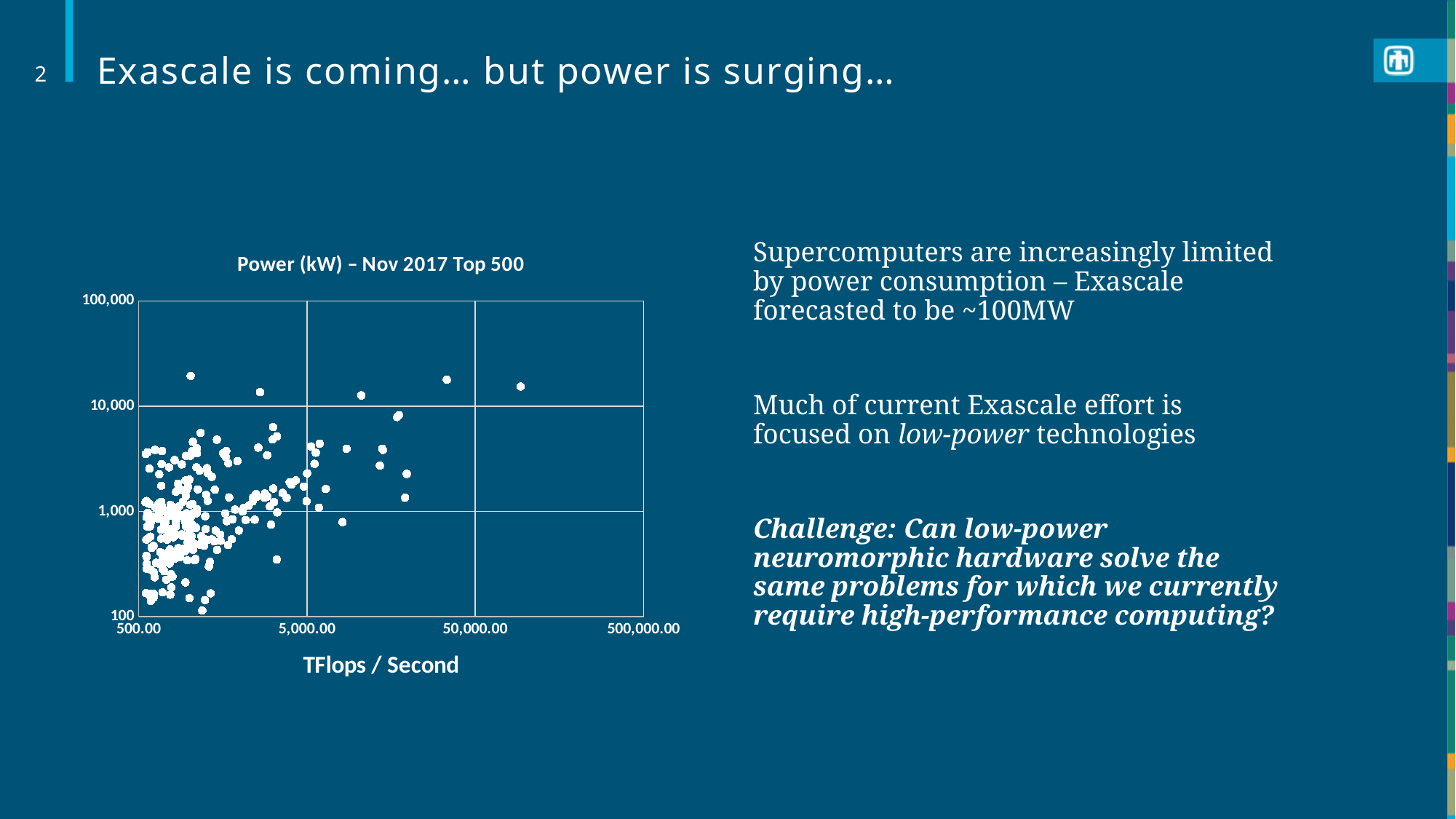
In general, does power tend to rise or fall as TFlops / Second increases along the x axis? Rise How many y-axis tick labels are shown on the chart? 4 What is the smallest tick value shown on the x axis of the chart? 500.00 Is the power value of the rightmost point in the chart greater or less than 10,000? greater What kind of chart is shown on the slide? Scatter chart Are the points in the chart mostly clustered at the low end or the high end of the x axis? Low end What is the highest tick value shown on the y axis of the chart? 100,000 What is the lowest tick value shown on the y axis of the chart? 100 What is the title of the chart? Power (kW) – Nov 2017 Top 500 Is the power value of the rightmost point in the chart greater or less than 100,000? less What is the label of the x axis of the chart? TFlops / Second What is the largest tick value shown on the x axis of the chart? 500,000.00